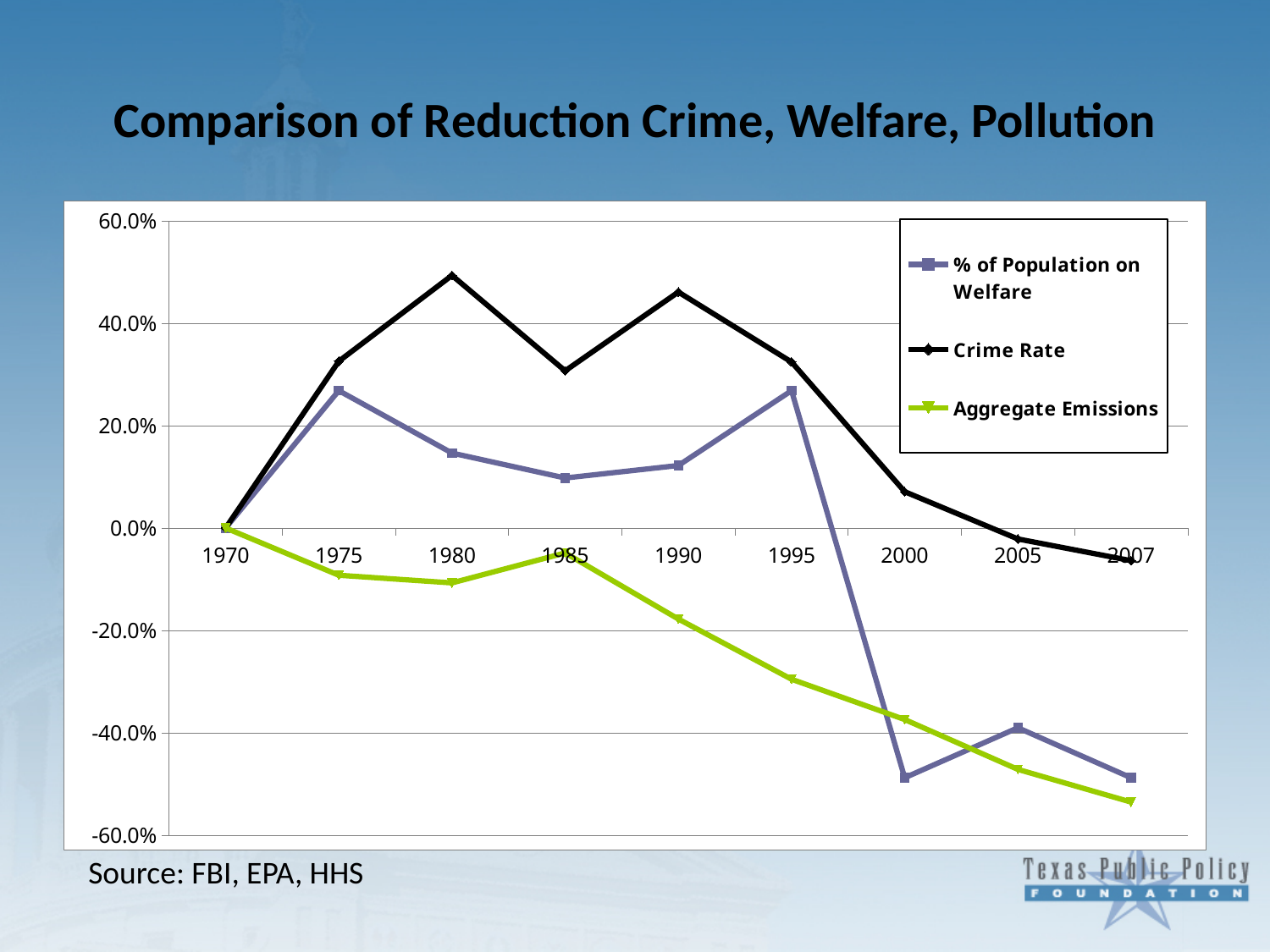
In 1995, which is higher: Crime Rate or % of Population on Welfare? Crime Rate Does the Aggregate Emissions series rise or fall from 1970 to 2007? fall In which year is the Crime Rate at its highest? 1980 Is the Crime Rate value for 1980 greater or less than 40.0%? greater What kind of chart is shown on the slide? line chart Is the % of Population on Welfare value for 2000 greater or less than -40.0%? less Is the Aggregate Emissions value for 2007 greater or less than -40.0%? less How many years are labelled along the x axis? 9 What is the Crime Rate value in 1970? 0.0% In which year is Aggregate Emissions at its lowest? 2007 How many series does the legend list? 3 What is the title of the chart? Comparison of Reduction Crime, Welfare, Pollution